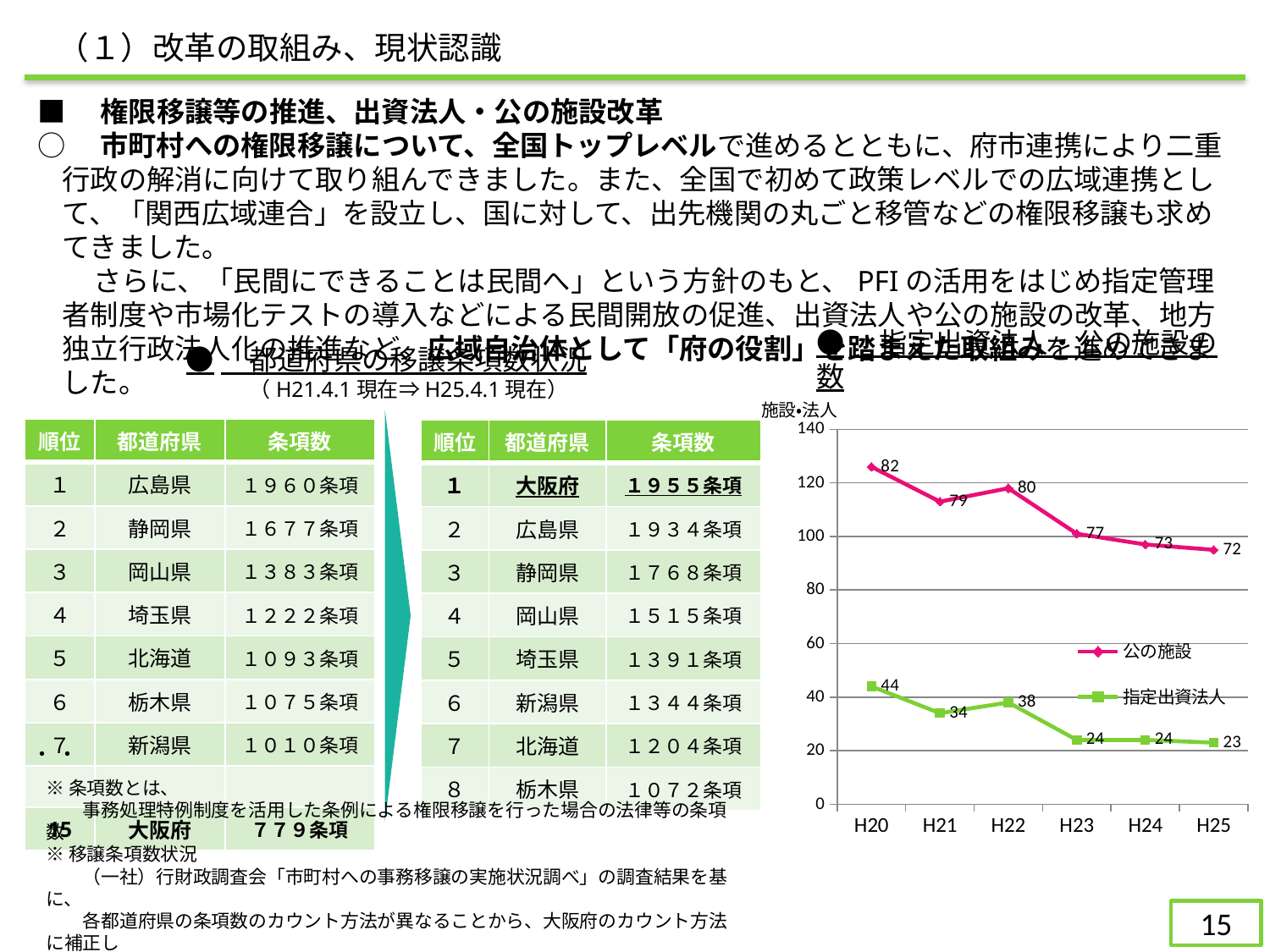
Does the 指定出資法人 series generally rise or fall from H20 to H25? fall What is the value for 公の施設 in H20? 82 How many years are plotted on the x axis of the chart? 6 Which is larger in H23: the value for 公の施設 or for 指定出資法人? 公の施設 What is the difference between the 公の施設 value in H20 and in H25? 10 What is the value for 公の施設 in H25? 72 In which year is the value for 指定出資法人 highest? H20 What type of chart is shown on the slide? line chart How many series does the chart legend list? 2 In which year is the value for 公の施設 lowest? H25 What is the value for 指定出資法人 in H22? 38 What is the difference between the 指定出資法人 value in H20 and in H21? 10